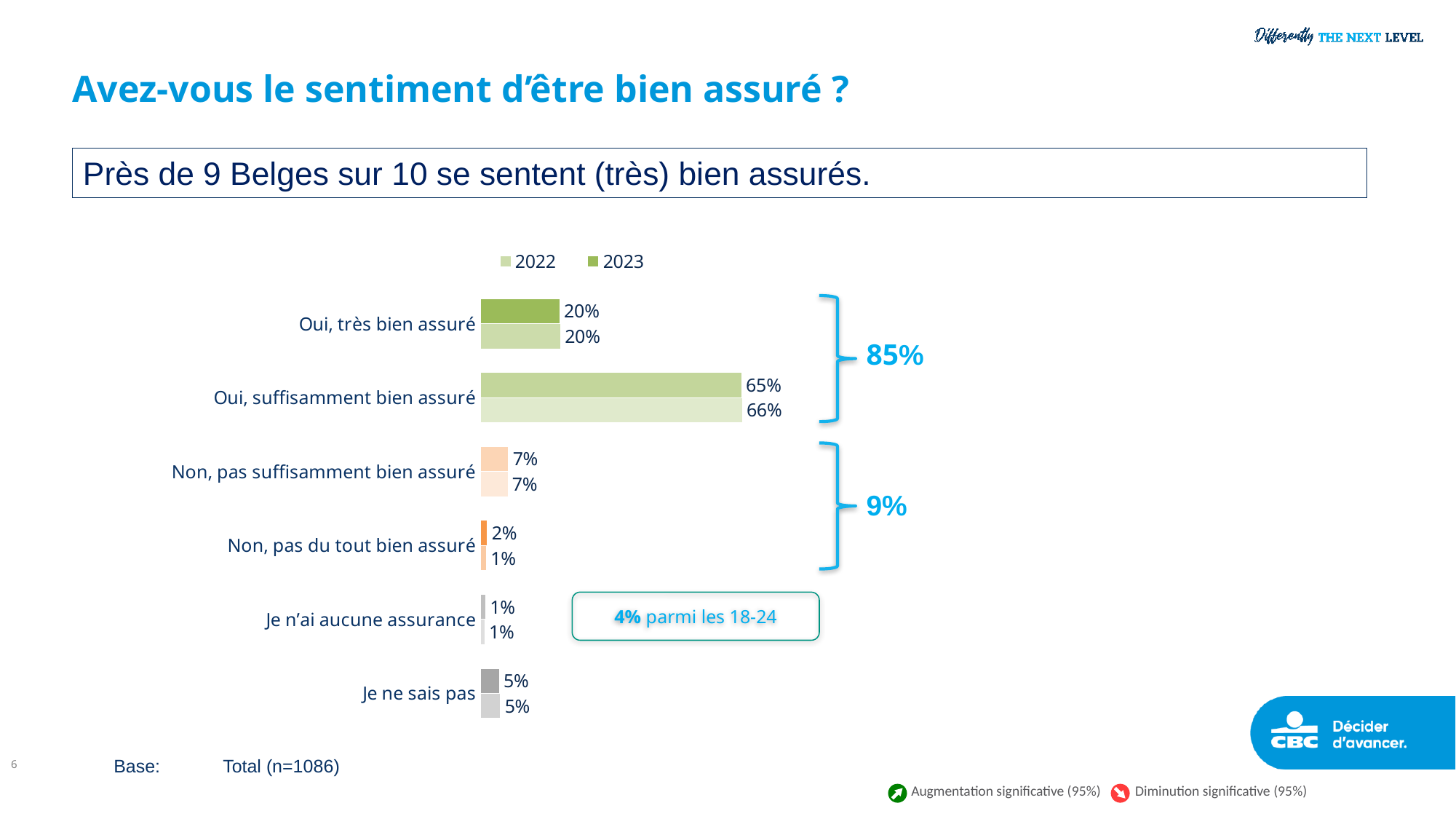
How many series does the legend list? 2 What is the 2023 value for "Oui, suffisamment bien assuré"? 65% What kind of chart is shown on the slide? Bar chart How many categories are shown in the chart? 6 Which is larger for "Oui, suffisamment bien assuré": the 2022 value or the 2023 value? 2022 What is the 2022 value for "Je ne sais pas"? 5% What is the 2023 value for "Non, pas du tout bien assuré"? 2% Which years are listed in the chart legend? 2022 and 2023 Which category has the highest value in 2023? Oui, suffisamment bien assuré What is the 2022 value for "Oui, suffisamment bien assuré"? 66% What is the difference between the 2022 and 2023 values for "Non, pas du tout bien assuré"? 1% What is the combined percentage shown by the bracket for the two "Oui" categories? 85%